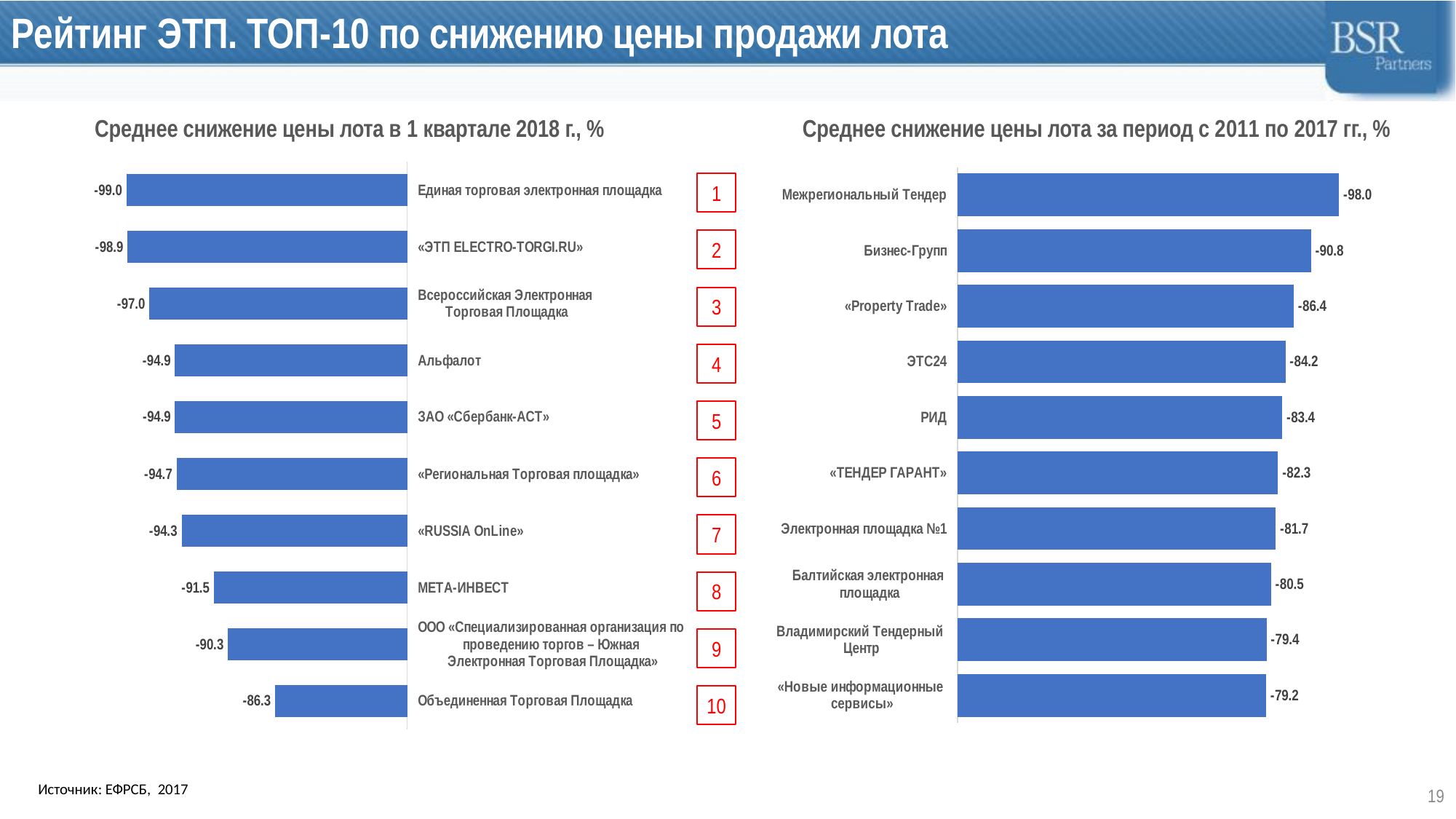
In the right chart (Среднее снижение цены лота за период с 2011 по 2017 гг., %), what is the value for ЭТС24? -84.2 In the left chart (Среднее снижение цены лота в 1 квартале 2018 г., %), which platform has the smallest price decrease? Объединенная Торговая Площадка In the left chart (Среднее снижение цены лота в 1 квартале 2018 г., %), what is the value for Альфалот? -94.9 In the right chart (Среднее снижение цены лота за период с 2011 по 2017 гг., %), what is the difference in percentage points between the values for Межрегиональный Тендер and «Новые информационные сервисы»? 18.8 In the right chart (Среднее снижение цены лота за период с 2011 по 2017 гг., %), which platform has the largest price decrease? Межрегиональный Тендер In the left chart (Среднее снижение цены лота в 1 квартале 2018 г., %), what is the value for МЕТА-ИНВЕСТ? -91.5 In the right chart (Среднее снижение цены лота за период с 2011 по 2017 гг., %), which platform has the smallest price decrease? «Новые информационные сервисы» In the left chart (Среднее снижение цены лота в 1 квартале 2018 г., %), which platform has the largest price decrease? Единая торговая электронная площадка In the right chart (Среднее снижение цены лота за период с 2011 по 2017 гг., %), what is the value for Балтийская электронная площадка? -80.5 What type of chart is used on the right side of the slide? Bar chart In the right chart (Среднее снижение цены лота за период с 2011 по 2017 гг., %), which has the larger price decrease: Бизнес-Групп or «Property Trade»? Бизнес-Групп How many platforms are shown in the left chart (Среднее снижение цены лота в 1 квартале 2018 г., %)? 10